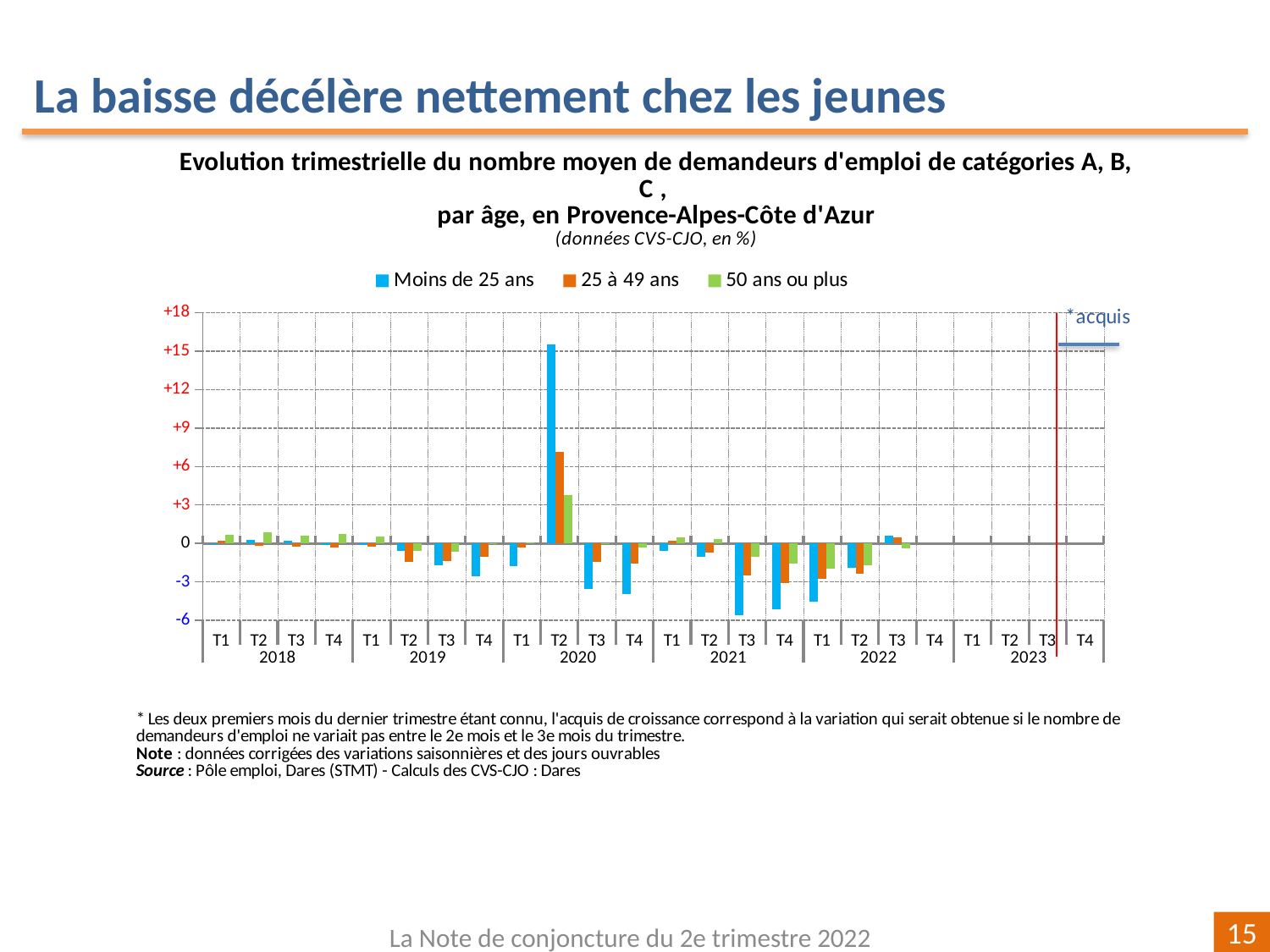
Is the value for 'Moins de 25 ans' in T1 2022 greater or less than -3? less Is the value for '25 à 49 ans' in T2 2020 greater or less than +6? greater Is the value for 'Moins de 25 ans' in T3 2021 greater or less than -3? less Which region does the chart title say the data covers? Provence-Alpes-Côte d'Azur How many series does the legend list? 3 Does the value for 'Moins de 25 ans' rise or fall from T1 2022 to T3 2022? rise In which quarter does the 'Moins de 25 ans' series reach its highest value? T2 2020 In T3 2021, which is lower: 'Moins de 25 ans' or '25 à 49 ans'? Moins de 25 ans What kind of chart is shown on the slide? bar chart Which series has the highest value in T2 2020? Moins de 25 ans How many years are labelled on the x axis? 6